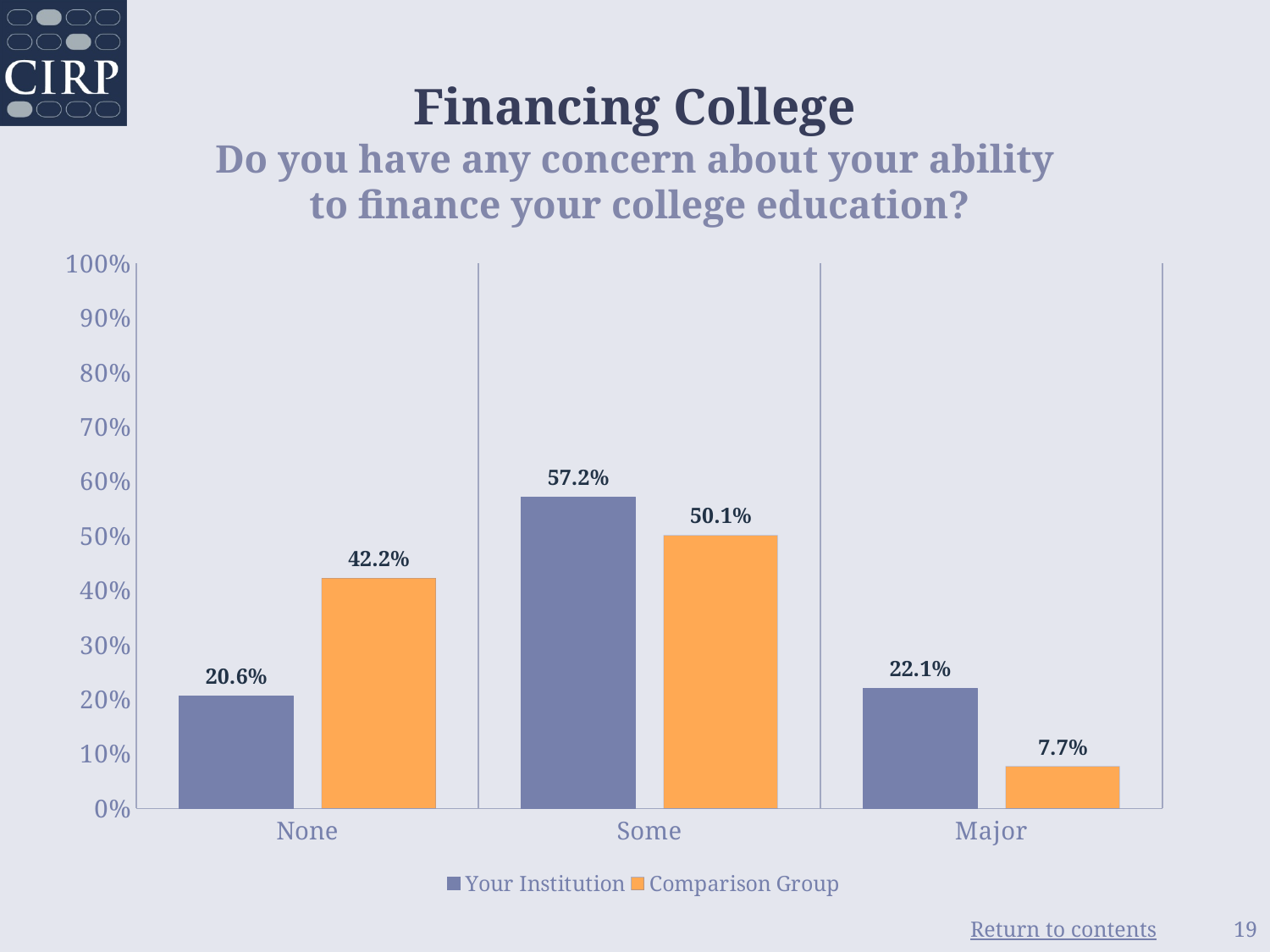
Which category has the highest value for Your Institution? Some What is the difference between Your Institution and Comparison Group in the None category? 21.6% What kind of chart is shown on the slide? bar chart Which category has the lowest value for Comparison Group? Major What is the value for Comparison Group in the Major category? 7.7% What is the value for Your Institution in the None category? 20.6% Which is larger in the Some category, Your Institution or Comparison Group? Your Institution How many series does the legend list? 2 Is the value for Comparison Group in the None category greater or less than 40%? greater How many categories are shown on the x axis? 3 What is the difference between Your Institution and Comparison Group in the Major category? 14.4% What is the value for Comparison Group in the Some category? 50.1%